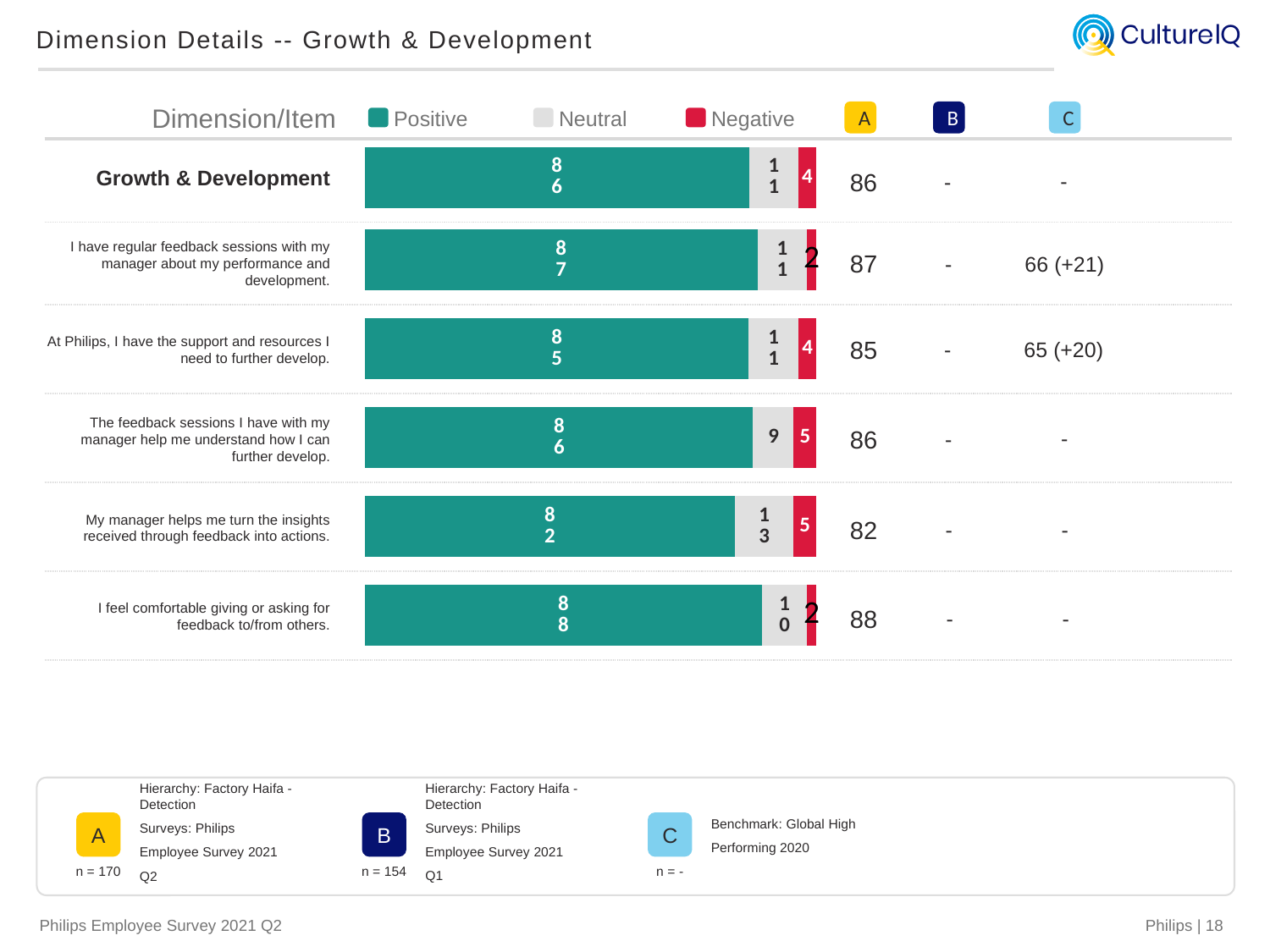
How many series does the legend list? 3 What is the difference between the Positive values for "I have regular feedback sessions with my manager about my performance and development." and "At Philips, I have the support and resources I need to further develop."? 2 Which colour represents the Negative series in the legend? Red Which item has the highest Positive value? I feel comfortable giving or asking for feedback to/from others. What is the Positive value for the item "I feel comfortable giving or asking for feedback to/from others."? 88 What is the value shown in column C for the item "At Philips, I have the support and resources I need to further develop."? 65 (+20) What is the Negative value for the item "The feedback sessions I have with my manager help me understand how I can further develop."? 5 Which has a larger Negative value: "At Philips, I have the support and resources I need to further develop." or "I have regular feedback sessions with my manager about my performance and development."? At Philips, I have the support and resources I need to further develop. What is the Neutral value for the item "My manager helps me turn the insights received through feedback into actions."? 13 What kind of chart is used to show the Positive, Neutral and Negative values? Stacked bar chart How many items (rows) are plotted in the chart, including the overall Growth & Development row? 6 Which item has the lowest Positive value? My manager helps me turn the insights received through feedback into actions.